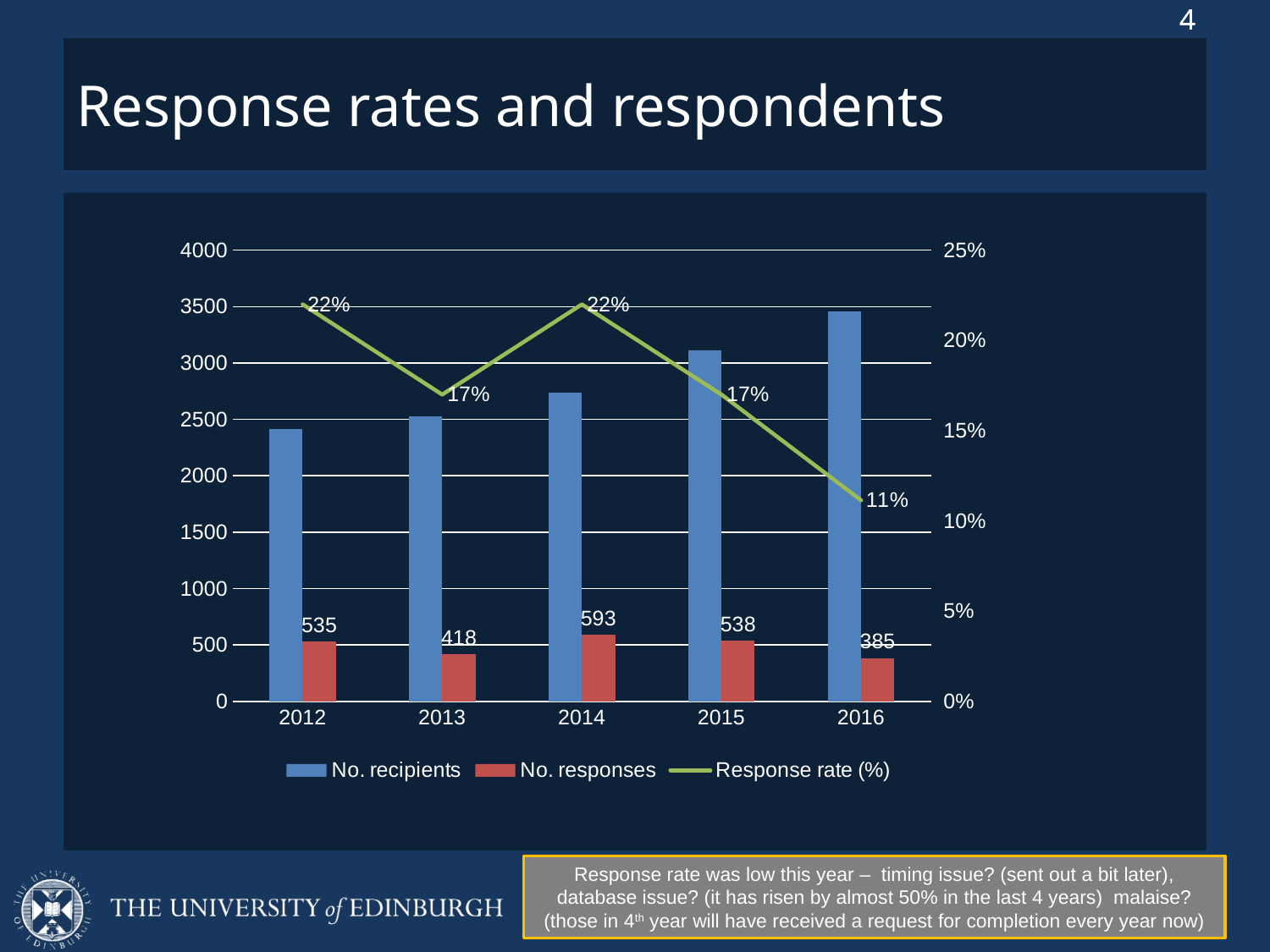
Does the number of recipients rise or fall from 2012 to 2016? rise What is the response rate shown for 2016? 11% How many series does the legend list? 3 What is the difference between the number of responses in 2014 and in 2016? 208 How many years are shown on the x axis? 5 Which year has the lowest response rate? 2016 Which is larger, the number of responses in 2012 or in 2015? 2015 Is the number of recipients in 2012 greater or less than 2500? less Is the number of recipients in 2016 greater or less than 3000? greater Which year has the highest number of responses? 2014 What is the number of responses in 2014? 593 What is the number of responses in 2013? 418